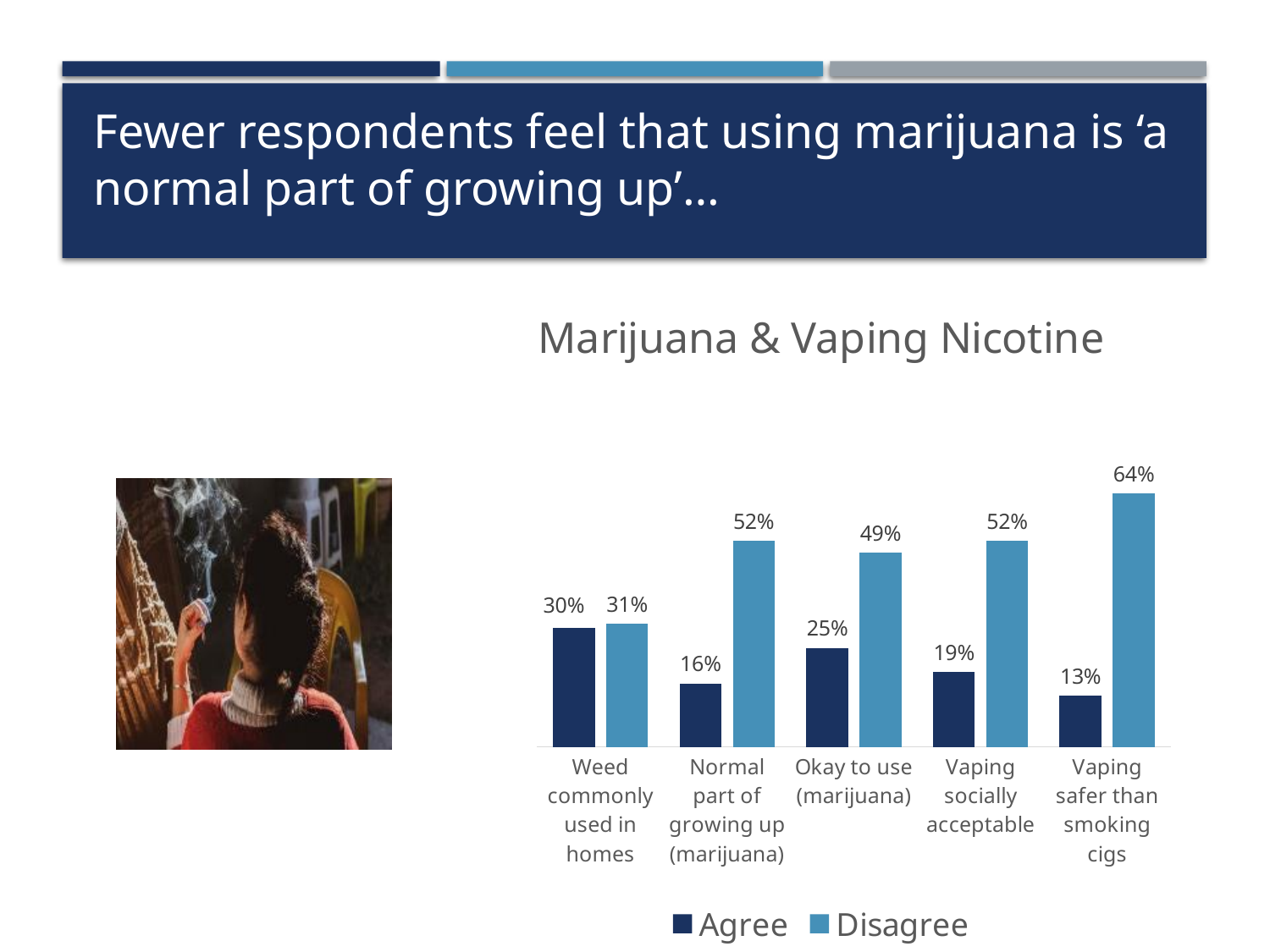
Which category has the lowest Agree value? Vaping safer than smoking cigs How many categories are shown on the x axis of the chart? 5 What is the Disagree value for 'Okay to use (marijuana)'? 49% How many series does the legend list? 2 What is the title of the chart? Marijuana & Vaping Nicotine Which category has the highest Disagree value? Vaping safer than smoking cigs What is the difference between the Disagree and Agree values for 'Vaping socially acceptable'? 33% What percentage of respondents agree that weed is commonly used in homes? 30% Which is larger for 'Weed commonly used in homes': the Agree value or the Disagree value? Disagree What percentage of respondents disagree that vaping is safer than smoking cigs? 64% What kind of chart is shown on the slide? Bar chart What is the Agree value for 'Normal part of growing up (marijuana)'? 16%